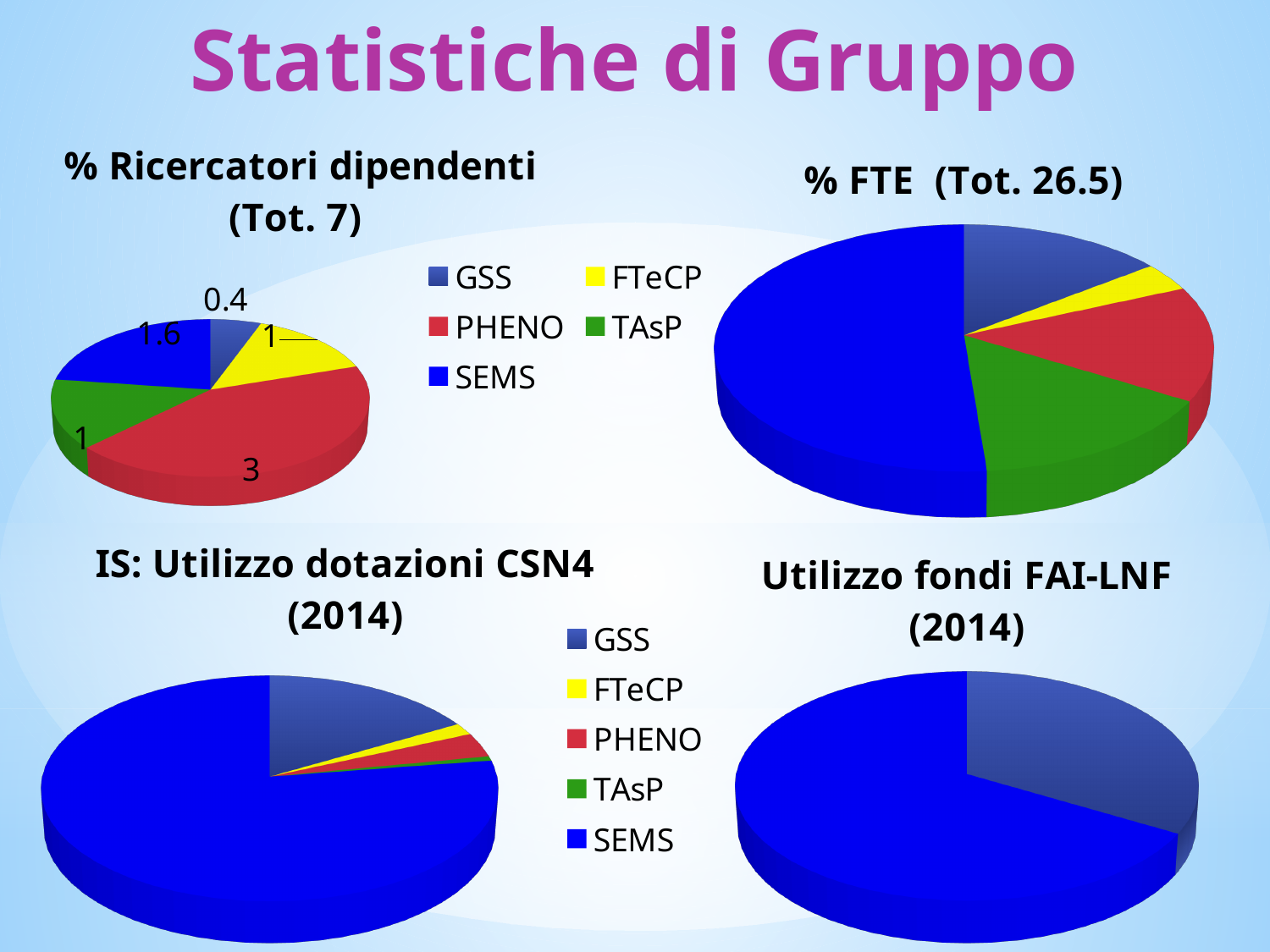
In the '% Ricercatori dipendenti (Tot. 7)' chart, what is the value for GSS? 0.4 What kind of chart is the '% FTE (Tot. 26.5)' chart? Pie chart In the '% Ricercatori dipendenti (Tot. 7)' chart, which is larger, the value for SEMS or the value for FTeCP? SEMS In the '% Ricercatori dipendenti (Tot. 7)' chart, what is the difference between the PHENO value and the SEMS value? 1.4 In the '% Ricercatori dipendenti (Tot. 7)' chart, what is the value for SEMS? 1.6 In the '% Ricercatori dipendenti (Tot. 7)' chart, what is the value for PHENO? 3 In the 'Utilizzo fondi FAI-LNF (2014)' chart, which is larger, the slice for SEMS or the slice for GSS? SEMS In the '% Ricercatori dipendenti (Tot. 7)' chart, which category has the largest slice? PHENO In the '% Ricercatori dipendenti (Tot. 7)' chart, which category has the smallest slice? GSS In the 'IS: Utilizzo dotazioni CSN4 (2014)' chart, which category has the largest slice? SEMS In the '% FTE (Tot. 26.5)' chart, which category has the largest slice? SEMS How many categories does the legend of the '% Ricercatori dipendenti (Tot. 7)' chart list? 5